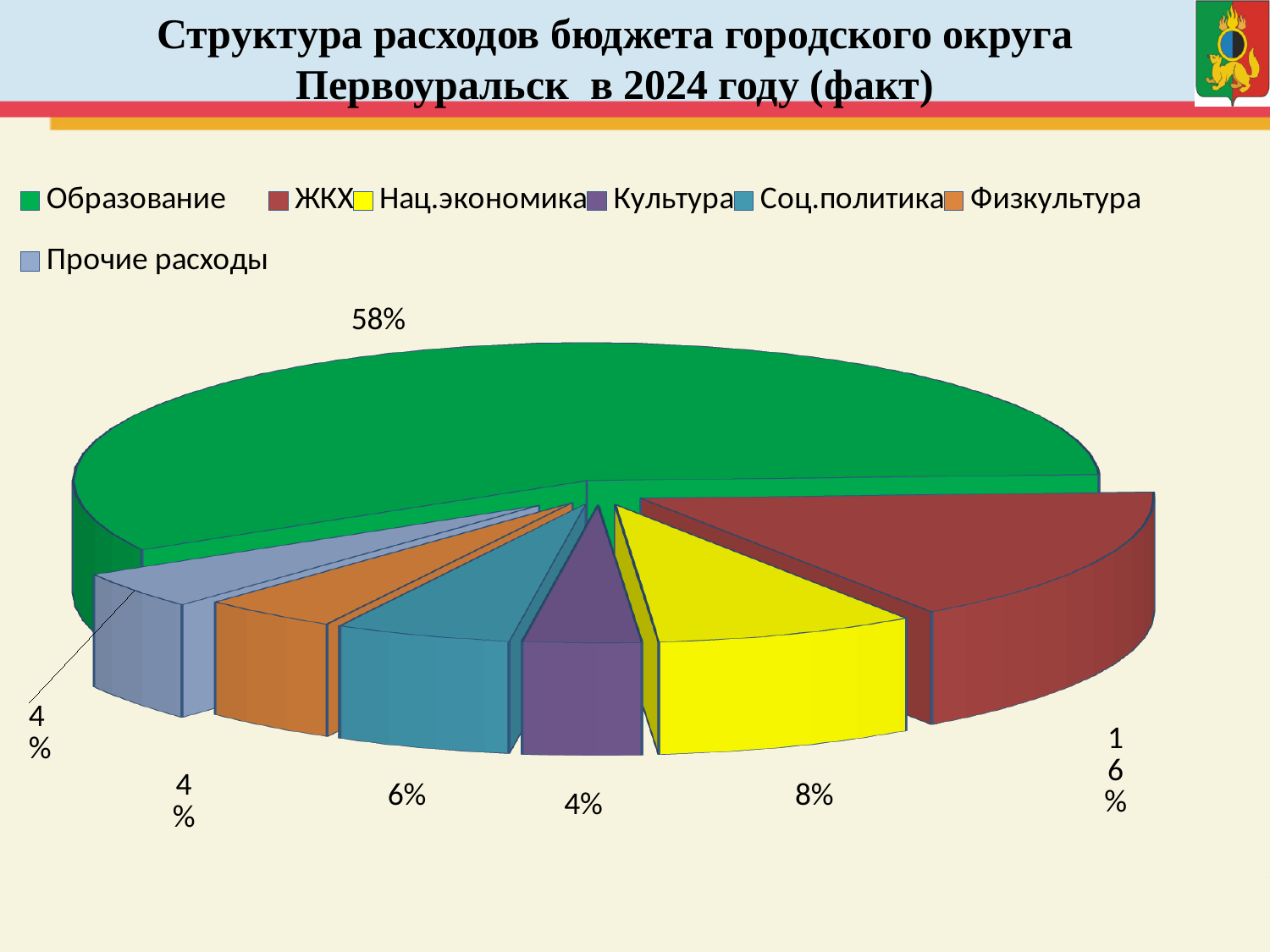
What percentage is shown for Нац.экономика? 8% What is the difference in percentage points between Образование and ЖКХ? 42 What share of the budget expenditure goes to Образование? 58% Which is larger, the share for Нац.экономика or the share for Соц.политика? Нац.экономика What percentage is shown for ЖКХ? 16% What percentage is shown for Культура? 4% What colour is the slice for Образование? green Which category has the largest share of the pie? Образование What type of chart is shown on the slide? pie chart How many slices does the pie chart have? 7 What percentage is shown for Соц.политика? 6% How many categories does the legend list? 7